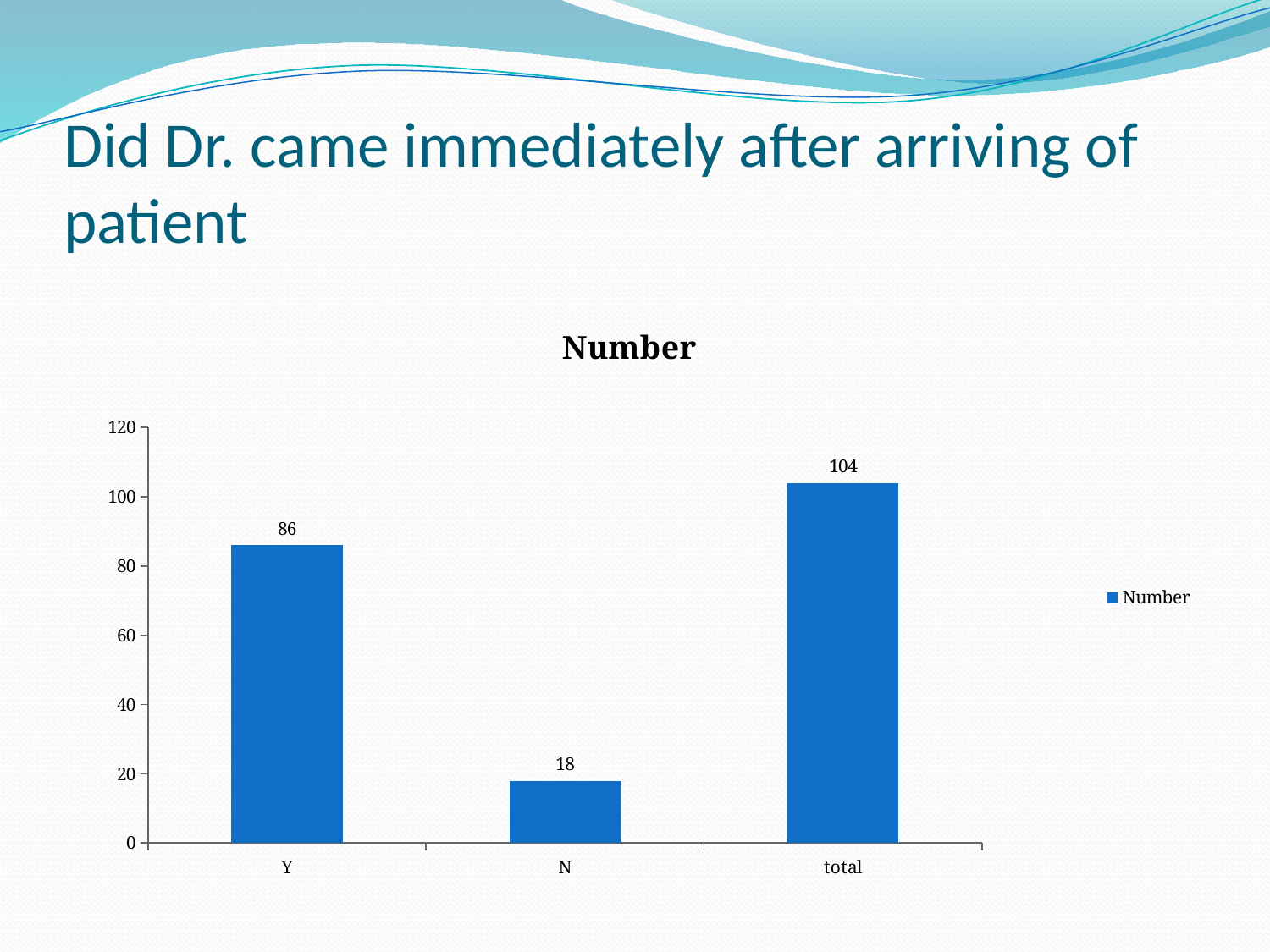
How many series does the legend list? 1 What is the value for N? 18 What is the difference between the values for Y and N? 68 What is the title of the chart? Number Is the value for N greater or less than 20? less What is the value for total? 104 What kind of chart is shown? bar chart Which is larger, the value for Y or the value for N? Y What is the value for Y? 86 Which category has the lowest value? N Which category has the highest value? total How many categories are shown on the x axis? 3